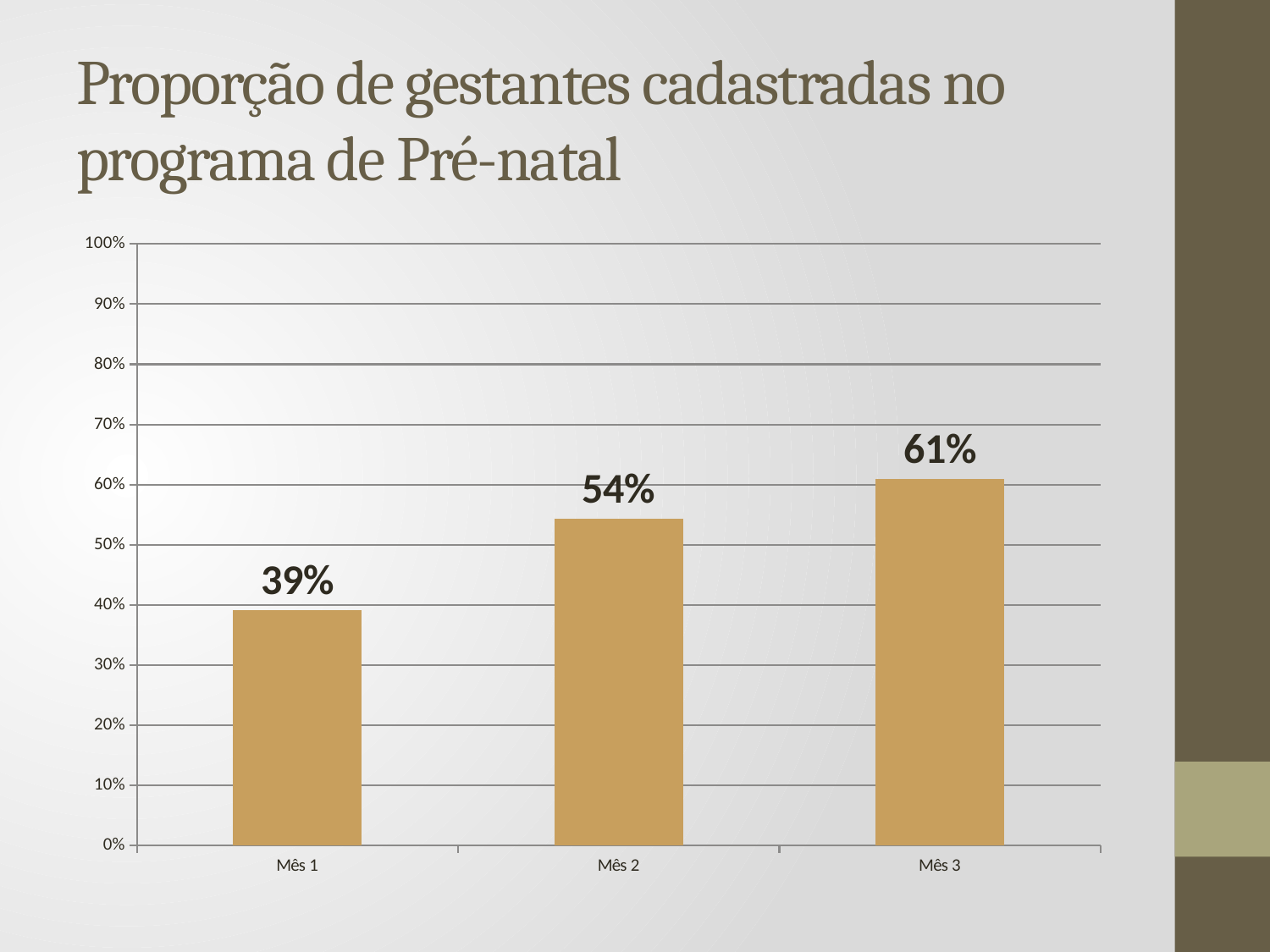
What is the value for Mês 2? 54% What kind of chart is shown on the slide? bar chart What is the value for Mês 3? 61% How many months are shown on the x axis? 3 Is the value for Mês 2 greater or less than 50%? greater What is the value for Mês 1? 39% What is the difference between the values for Mês 3 and Mês 1? 22% Which month has the highest proportion? Mês 3 Do the values rise or fall from Mês 1 to Mês 3? rise Which month has the lowest proportion? Mês 1 What is the difference between the values for Mês 2 and Mês 1? 15% Which is larger, the value for Mês 2 or the value for Mês 3? Mês 3